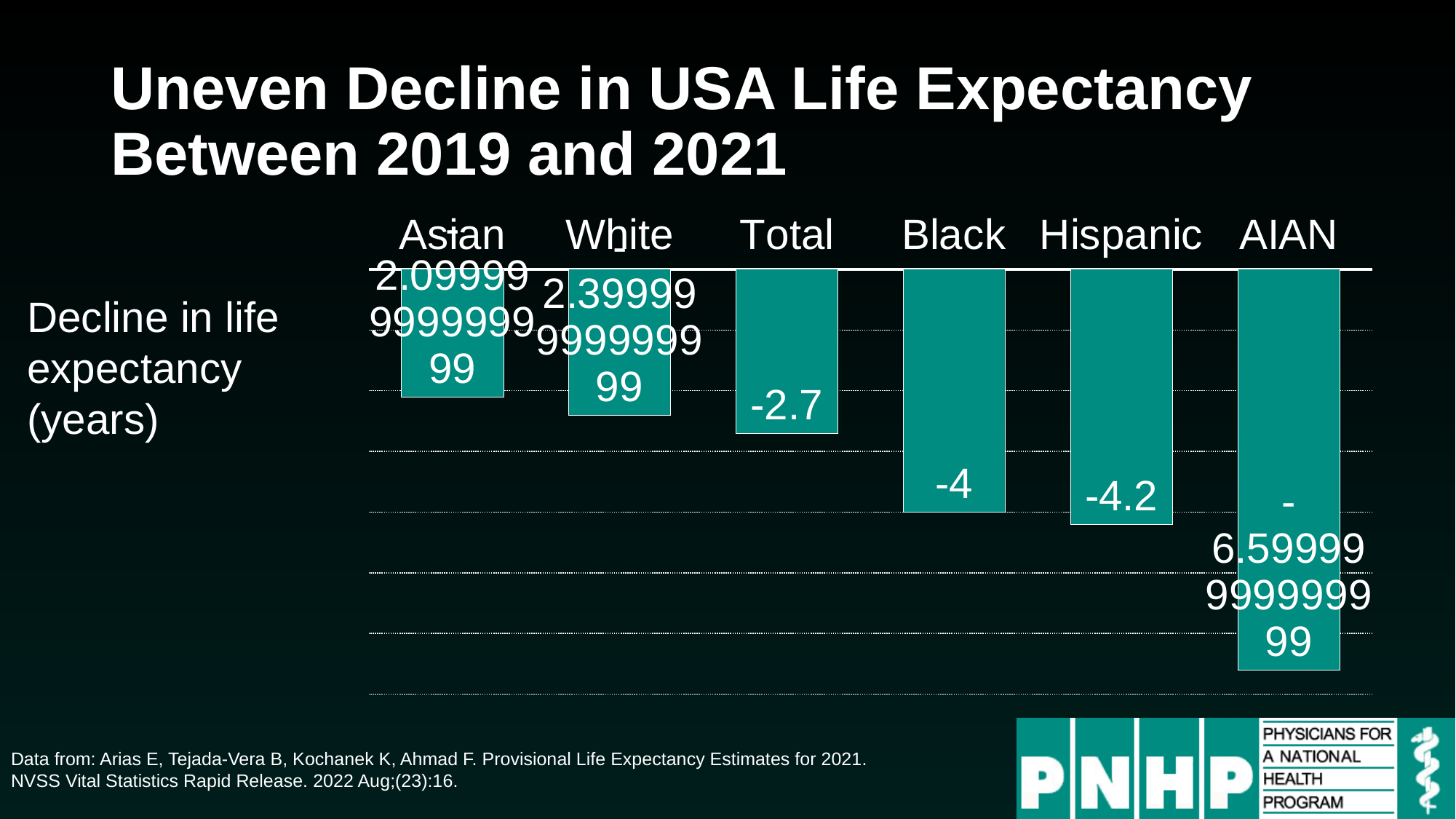
What is the value shown for Total? -2.7 Which category shows the smallest decline in life expectancy (the shortest bar)? Asian What is the value shown for Hispanic? -4.2 What is the difference between the values for Total and Black? 1.3 How many categories (bars) are shown in the chart? 6 Moving from left to right across the categories, do the declines in life expectancy get larger or smaller? larger Which group has a larger decline in life expectancy, Black or Hispanic? Hispanic Which category shows the largest decline in life expectancy (the longest bar)? AIAN What is the title of the chart on the slide? Uneven Decline in USA Life Expectancy Between 2019 and 2021 What is the value shown for Black? -4 What is the difference between the values for Black and Hispanic? 0.2 What type of chart is shown on the slide? bar chart